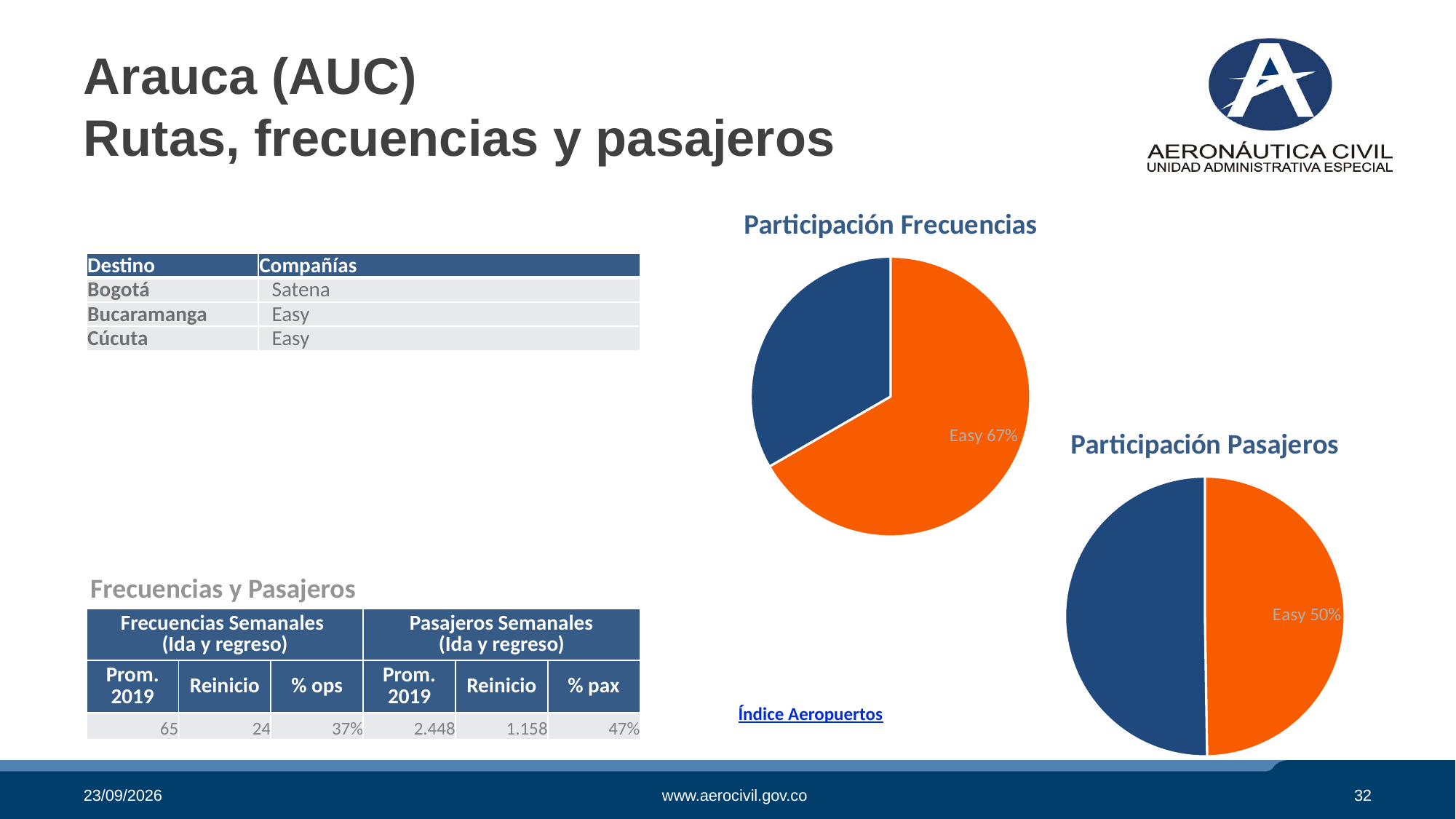
How many slices does the "Participación Frecuencias" pie chart have? 2 In the "Participación Frecuencias" chart, what share of the pie does Easy have? 67% What kind of chart is the "Participación Frecuencias" chart? pie chart In the "Participación Frecuencias" chart, is the Easy slice larger or smaller than the other slice? larger What kind of chart is the "Participación Pasajeros" chart? pie chart How many slices does the "Participación Pasajeros" pie chart have? 2 In the "Participación Pasajeros" chart, what share of the pie does Easy have? 50% In the "Participación Frecuencias" chart, which slice is the largest? Easy What colour is the Easy slice in the "Participación Pasajeros" chart? orange What is the title of the pie chart in the lower right of the slide? Participación Pasajeros